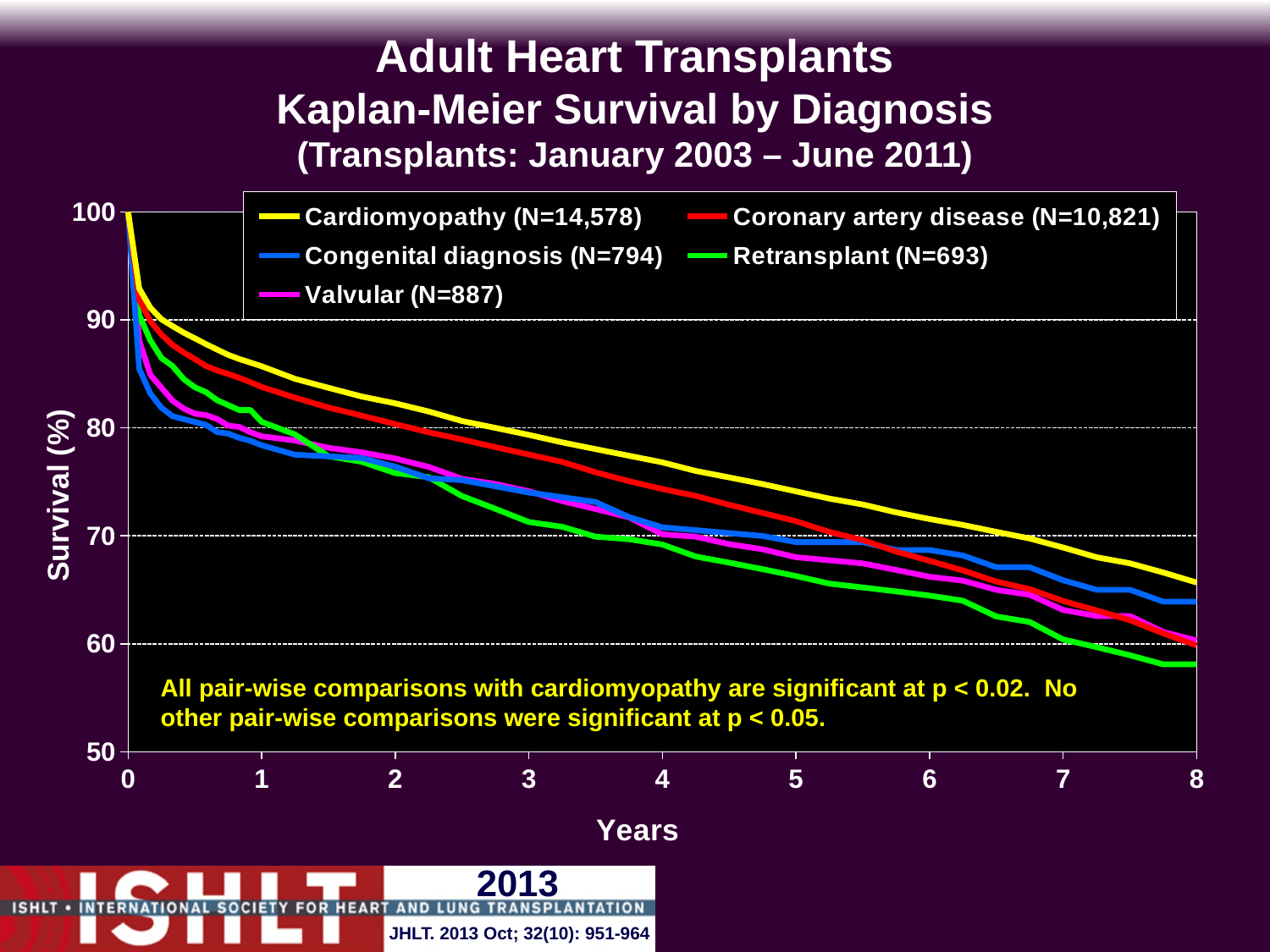
Is the survival for Retransplant at 8 years greater or less than 60? less Is the survival for Cardiomyopathy at 4 years greater or less than 70? greater At 8 years, which has higher survival: Congenital diagnosis or Retransplant? Congenital diagnosis At 2 years, which has higher survival: Cardiomyopathy or Retransplant? Cardiomyopathy What is the N for the Cardiomyopathy group shown in the legend? 14,578 How many series does the legend list? 5 Is the survival for Cardiomyopathy at 8 years greater or less than 60? greater Which diagnosis group has the lowest survival at 8 years? Retransplant Do the survival curves rise or fall as years increase? fall What kind of chart is shown on the slide? line chart What is the label of the y axis? Survival (%) Which diagnosis group has the highest survival at 8 years? Cardiomyopathy